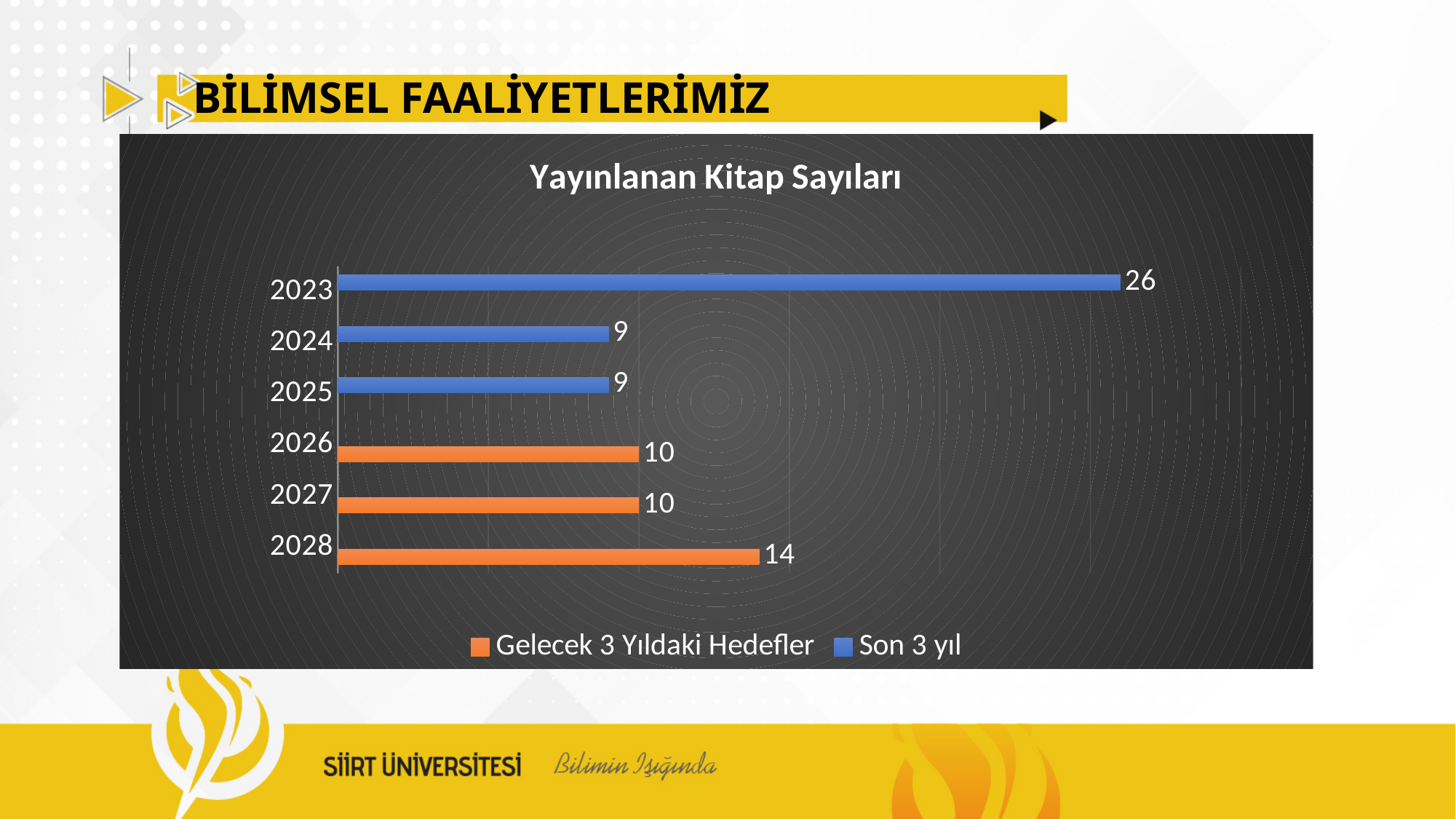
Which series in the Yayınlanan Kitap Sayıları chart is shown in orange? Gelecek 3 Yıldaki Hedefler What is the value for 2023 in the Yayınlanan Kitap Sayıları chart? 26 What is the value for 2028 in the Yayınlanan Kitap Sayıları chart? 14 How many years are shown in the Yayınlanan Kitap Sayıları chart? 6 What is the value for 2026 in the Yayınlanan Kitap Sayıları chart? 10 Which year has the highest value in the Yayınlanan Kitap Sayıları chart? 2023 What kind of chart is the Yayınlanan Kitap Sayıları chart? Bar chart What is the difference between the values for 2028 and 2027 in the Yayınlanan Kitap Sayıları chart? 4 What is the difference between the values for 2023 and 2024 in the Yayınlanan Kitap Sayıları chart? 17 How many series does the legend of the Yayınlanan Kitap Sayıları chart list? 2 Which is larger in the Yayınlanan Kitap Sayıları chart, the value for 2028 or the value for 2026? 2028 What is the value for 2025 in the Yayınlanan Kitap Sayıları chart? 9